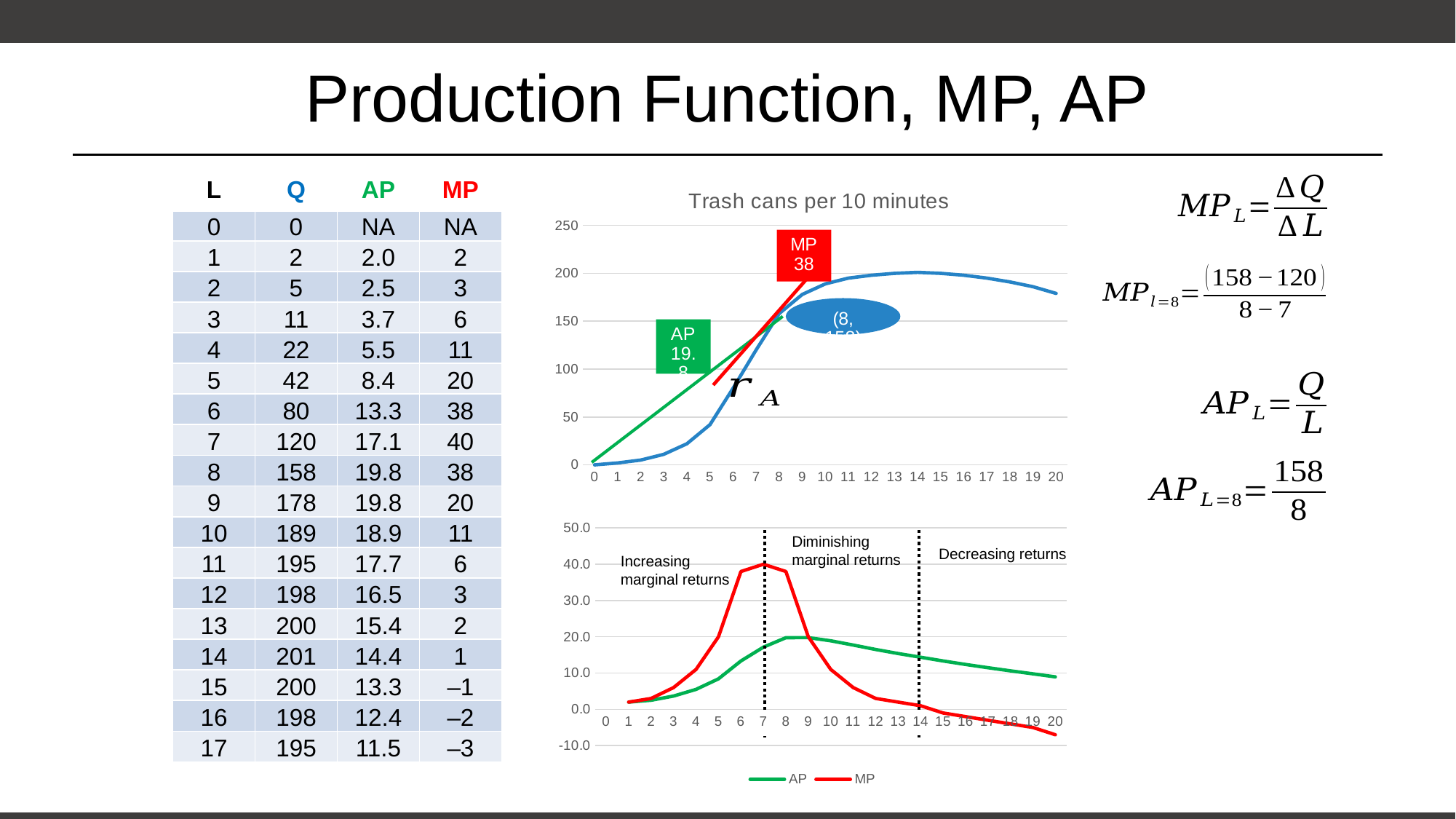
In the top chart, what MP value is shown in the red label? 38 In the top chart, is the value at L = 14 greater or less than 150? greater In the bottom chart, is the MP value at L = 6 greater or less than 30? greater What kind of chart is the top chart titled "Trash cans per 10 minutes"? line chart How many series does the legend of the bottom chart list? 2 In the bottom chart, at L = 12, which is larger, AP or MP? AP What is the title of the top chart? Trash cans per 10 minutes In the top chart, what is the output value at L = 8? 158 In the bottom chart, does the MP line rise or fall from L = 7 to L = 20? fall In the top chart, is the value at L = 5 greater or less than 50? less What are the two legend entries of the bottom chart? AP and MP In the bottom chart, at which value of L does the MP line reach its highest point? 7